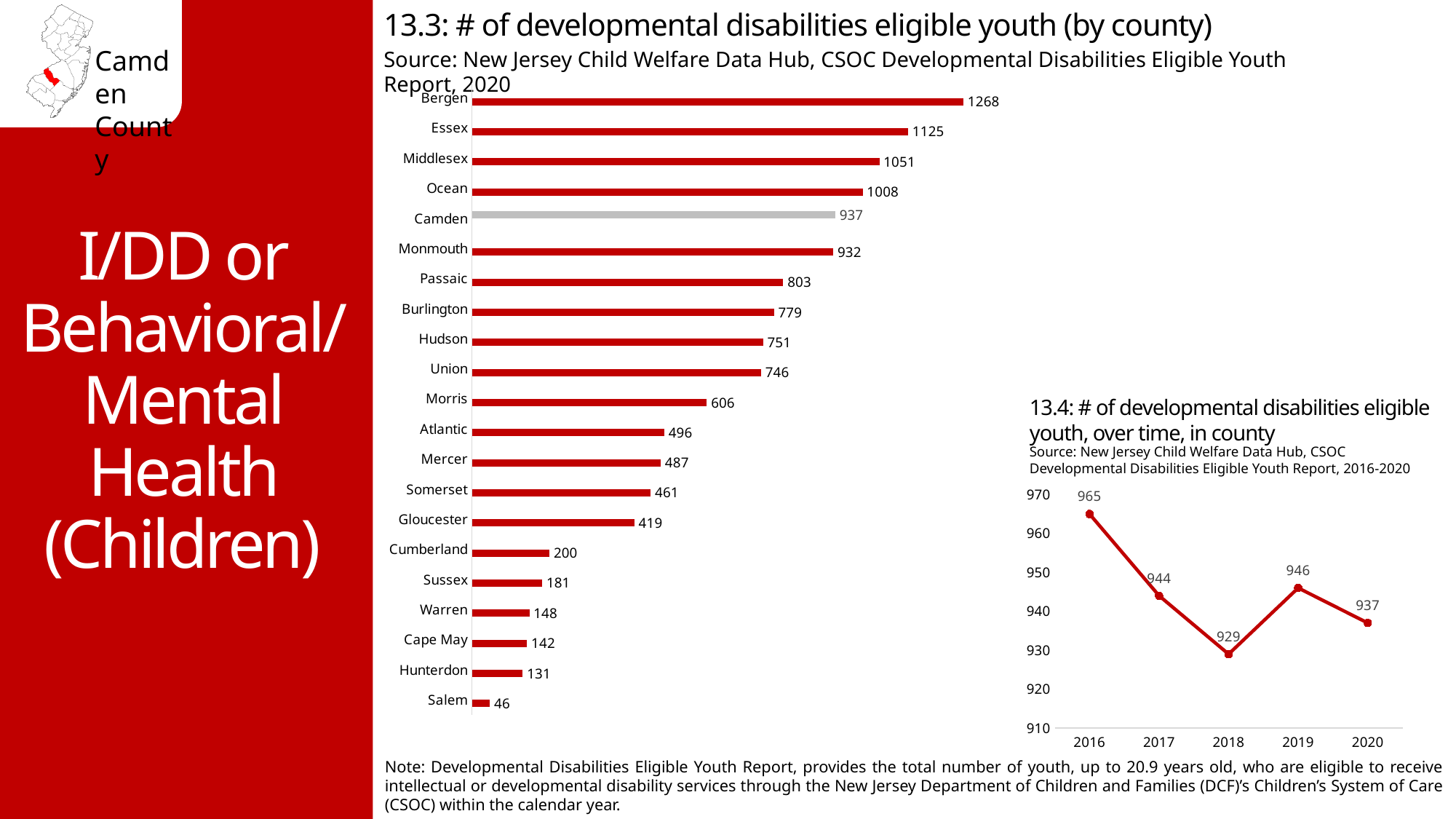
In chart 13.3 (by county), how many counties are shown? 21 In chart 13.4 (over time, in county), which year has the highest value? 2016 In chart 13.3 (by county), which county has the highest number of developmental disabilities eligible youth? Bergen What kind of chart is chart 13.3 (by county)? Bar chart In chart 13.3 (by county), what is the difference between the values for Bergen and Essex? 143 In chart 13.3 (by county), which county has the lowest number of developmental disabilities eligible youth? Salem What kind of chart is chart 13.4 (over time, in county)? Line chart In chart 13.3 (by county), what is the value for Gloucester? 419 In chart 13.4 (over time, in county), what is the difference between the 2019 and 2020 values? 9 In chart 13.4 (over time, in county), what is the value for 2018? 929 In chart 13.3 (# of developmental disabilities eligible youth by county), what is the value for Camden? 937 In chart 13.3 (by county), which has a larger value, Passaic or Burlington? Passaic